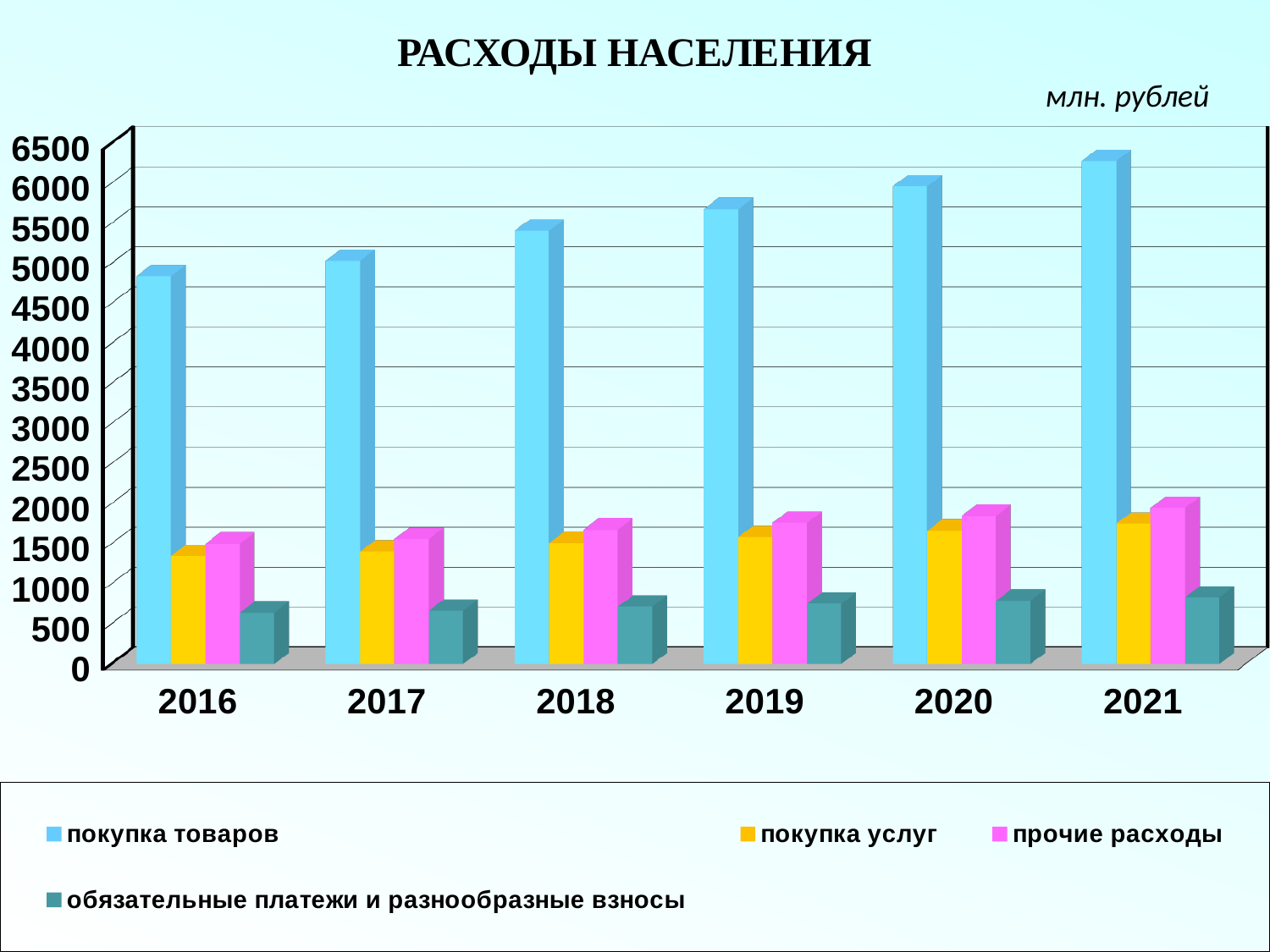
Which is larger in 2019: покупка услуг or прочие расходы? прочие расходы What kind of chart is shown on the slide? bar chart Is the value for покупка товаров in 2016 greater or less than 5000? less How many series does the legend list? 4 Is the value for покупка товаров in 2021 greater or less than 6000? greater What unit of measurement is stated on the slide for the chart values? млн. рублей In which year is the value for покупка товаров lowest? 2016 Do the values for покупка товаров rise or fall from 2016 to 2021? rise Is the value for обязательные платежи и разнообразные взносы in 2016 greater or less than 1000? less How many years are shown on the x axis? 6 In which year is the value for покупка товаров highest? 2021